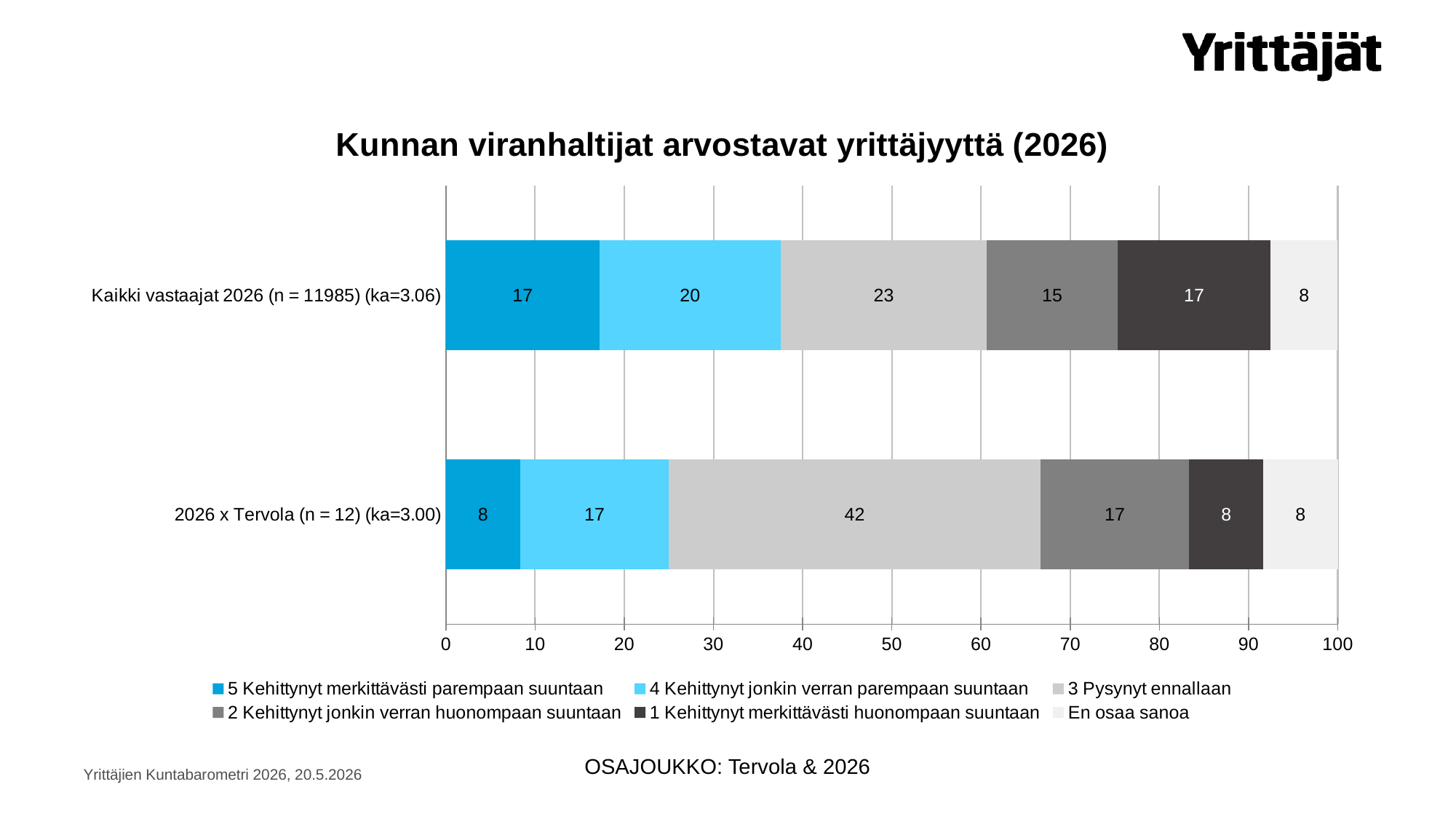
Which category has the higher value for "3 Pysynyt ennallaan"? 2026 x Tervola (n = 12) (ka=3.00) What is the title of the chart? Kunnan viranhaltijat arvostavat yrittäjyyttä (2026) What is the value of "5 Kehittynyt merkittävästi parempaan suuntaan" for "Kaikki vastaajat 2026 (n = 11985) (ka=3.06)"? 17 What is the value of "1 Kehittynyt merkittävästi huonompaan suuntaan" for "2026 x Tervola (n = 12) (ka=3.00)"? 8 How many series does the legend list? 6 What is the total of the stacked bar for "Kaikki vastaajat 2026 (n = 11985) (ka=3.06)"? 100 What is the value of "3 Pysynyt ennallaan" for "2026 x Tervola (n = 12) (ka=3.00)"? 42 What is the difference between the "5 Kehittynyt merkittävästi parempaan suuntaan" values of "Kaikki vastaajat 2026 (n = 11985) (ka=3.06)" and "2026 x Tervola (n = 12) (ka=3.00)"? 9 What is the value of "En osaa sanoa" for "Kaikki vastaajat 2026 (n = 11985) (ka=3.06)"? 8 What is the difference between the "3 Pysynyt ennallaan" values of "2026 x Tervola (n = 12) (ka=3.00)" and "Kaikki vastaajat 2026 (n = 11985) (ka=3.06)"? 19 What kind of chart is shown on the slide? Stacked bar chart How many categories are shown on the chart? 2